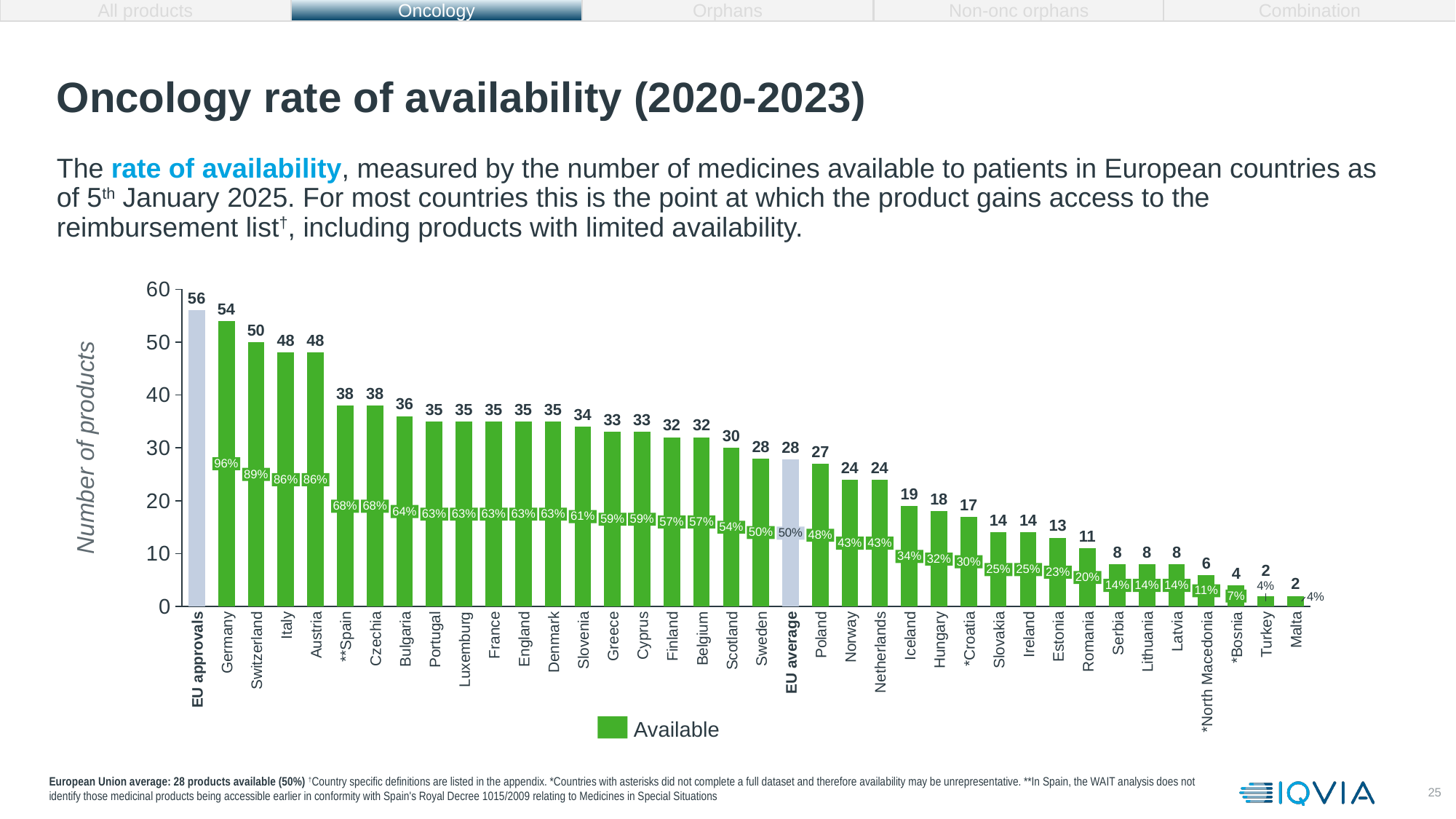
Which has more products available, Norway or Hungary? Norway What is the number of products for Germany? 54 How many bars are plotted in the chart? 38 How many series does the legend list? 1 What is the difference in number of products between EU approvals and Germany? 2 Which country has the highest number of products available (excluding EU approvals)? Germany What is the label of the y axis? Number of products What is the difference in number of products between Italy and Iceland? 29 What is the number of products for Poland? 27 What percentage is shown on the bar for Switzerland? 89% Is the value for Scotland greater or less than 20? greater What kind of chart is shown on the slide? Bar chart